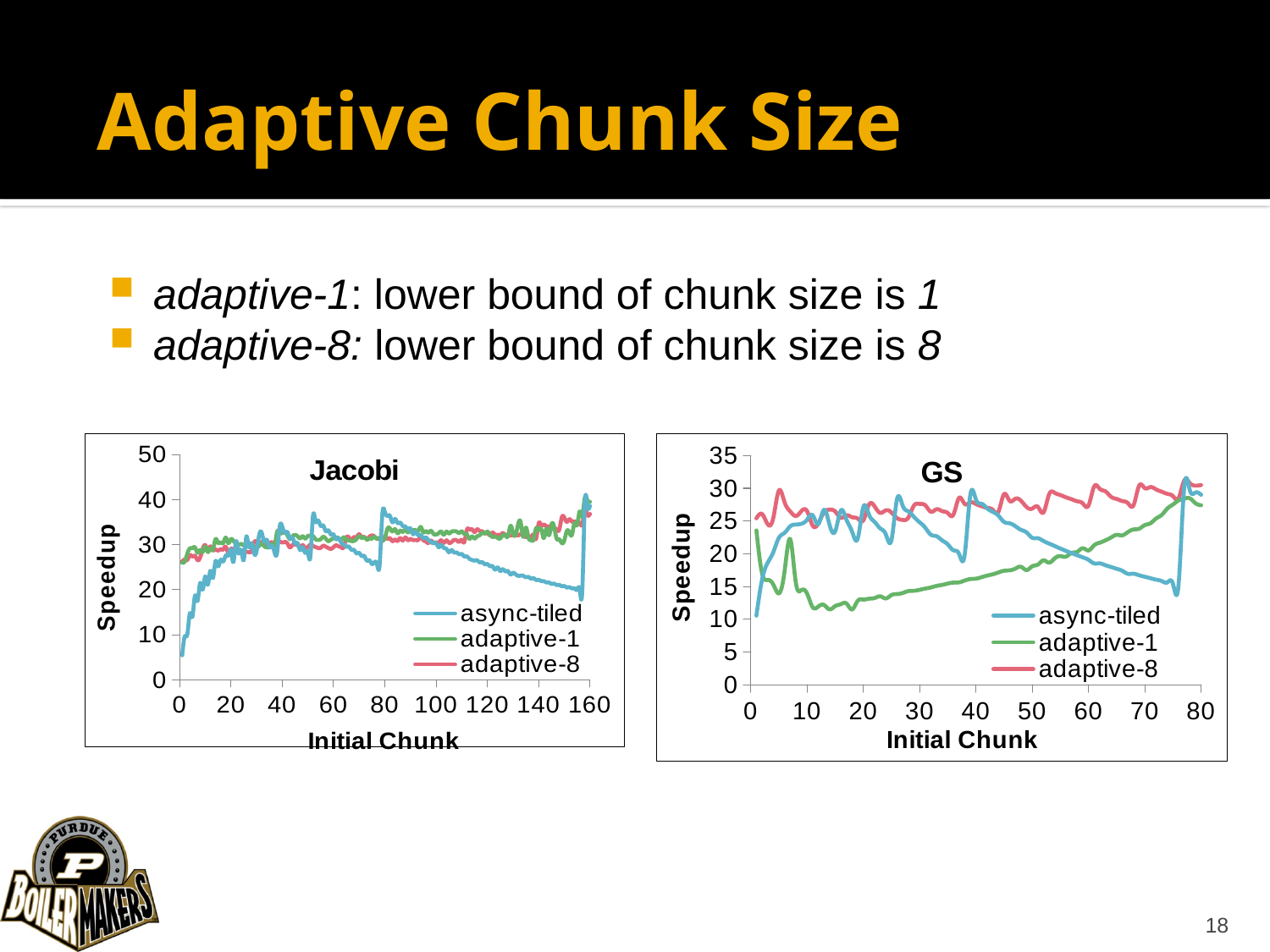
In the GS chart, does the adaptive-1 series rise or fall between initial chunk 20 and initial chunk 70? rise In the Jacobi chart, at an initial chunk of 140, which series is larger: adaptive-8 or async-tiled? adaptive-8 In the GS chart, is the value of adaptive-8 at an initial chunk of 40 greater or less than 20? greater In the Jacobi chart, is the value of adaptive-8 at an initial chunk of 100 greater or less than 20? greater What is the y-axis label on the Jacobi chart? Speedup In the Jacobi chart, does the async-tiled series rise or fall between initial chunk 80 and initial chunk 150? fall In the GS chart, is the value of adaptive-1 at an initial chunk of 20 greater or less than 20? less In the GS chart, at an initial chunk of 20, which series is larger: adaptive-8 or adaptive-1? adaptive-8 What is the x-axis label on the GS chart? Initial Chunk What kind of chart is the Jacobi chart? line chart How many series does the legend of the GS chart list? 3